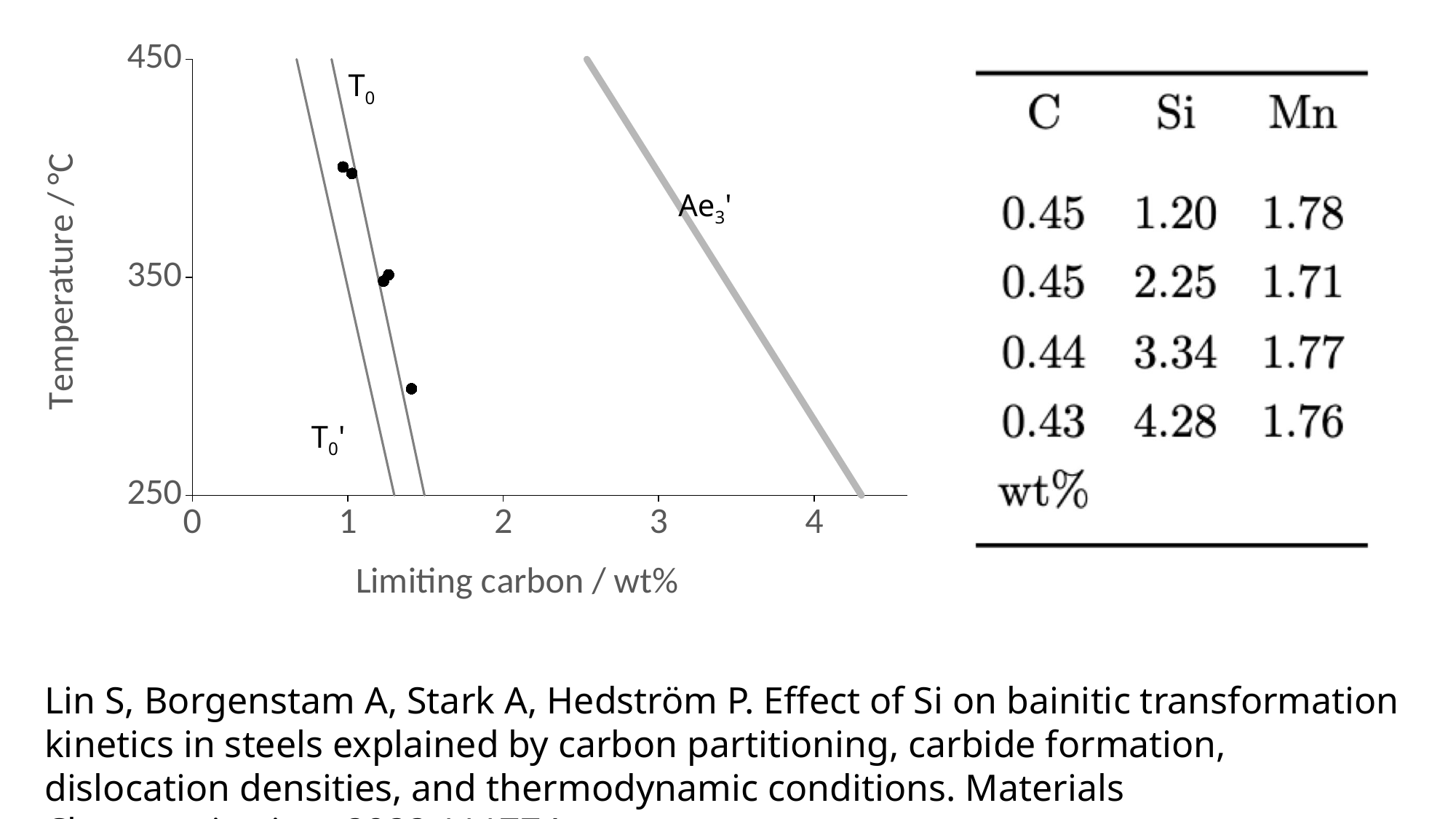
Is the temperature of the lowest plotted data point greater or less than 350 °C? less How many labelled lines are drawn on the chart? 3 Which line lies at higher limiting carbon values, Ae3' or T0? Ae3' Which line lies at lower limiting carbon values, T0 or T0'? T0' What kind of chart is shown on the slide? scatter chart What is the title of the y axis of the chart? Temperature / °C Where the Ae3' line reaches 250 °C, is its limiting carbon value greater or less than 4 wt%? greater As limiting carbon increases along the x axis, does the temperature along the Ae3' line rise or fall? fall Where the T0 line reaches 250 °C, is its limiting carbon value greater or less than 2 wt%? less What is the title of the x axis of the chart? Limiting carbon / wt%